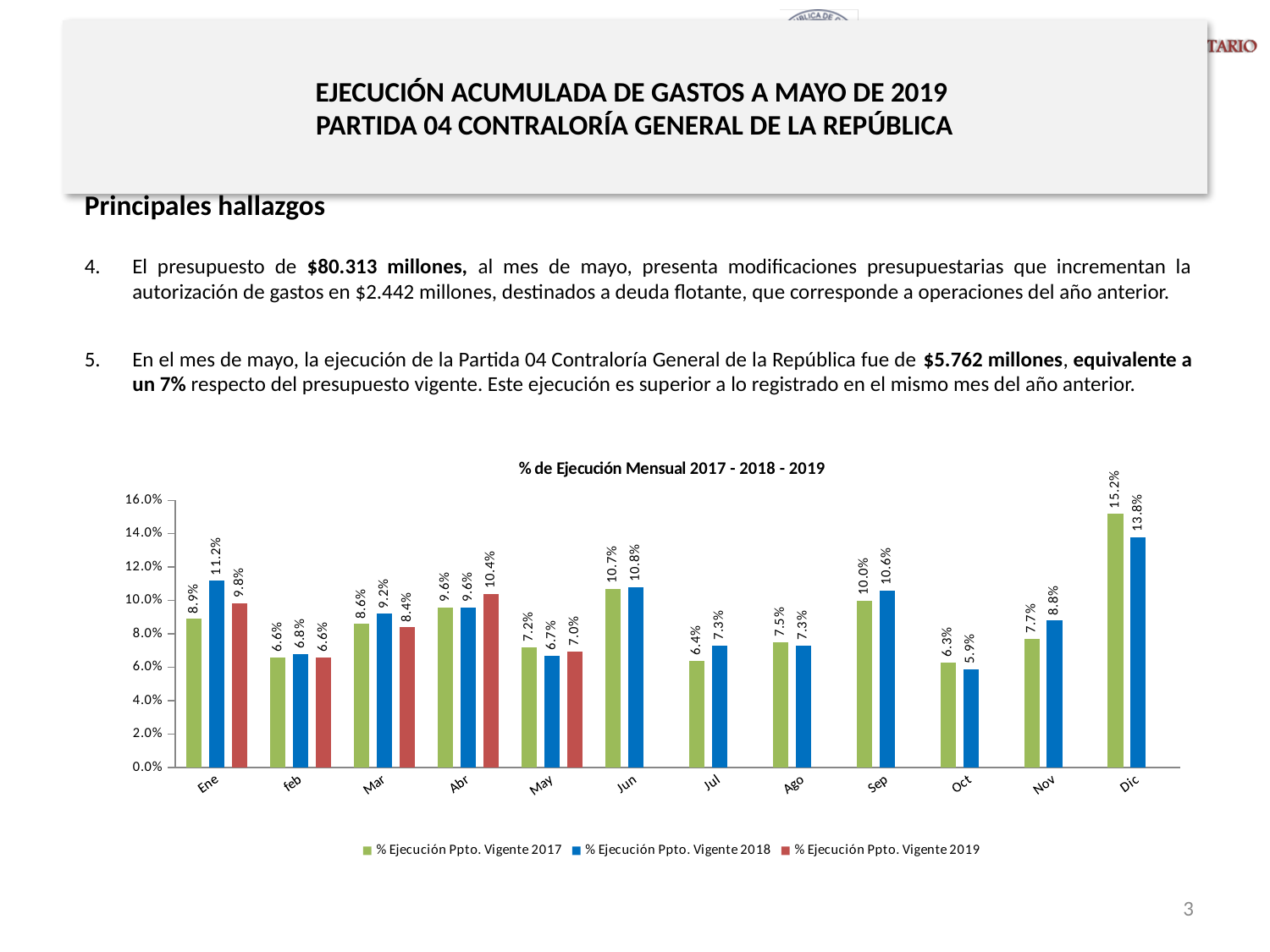
How many months are shown on the x axis? 12 What kind of chart is shown? Bar chart What is the title of the chart? % de Ejecución Mensual 2017 - 2018 - 2019 What is the value for % Ejecución Ppto. Vigente 2019 in Abr? 10.4% Is the value for % Ejecución Ppto. Vigente 2018 in Oct greater or less than 6.0%? less In which month is the % Ejecución Ppto. Vigente 2017 series lowest? Oct In which month is the % Ejecución Ppto. Vigente 2018 series highest? Dic How many series does the legend list? 3 What is the value for % Ejecución Ppto. Vigente 2018 in Ene? 11.2% What is the difference between the 2018 and 2017 values in Ene? 2.3% Which is larger in May: the 2017 value or the 2019 value? 2017 value What is the value for % Ejecución Ppto. Vigente 2017 in Dic? 15.2%